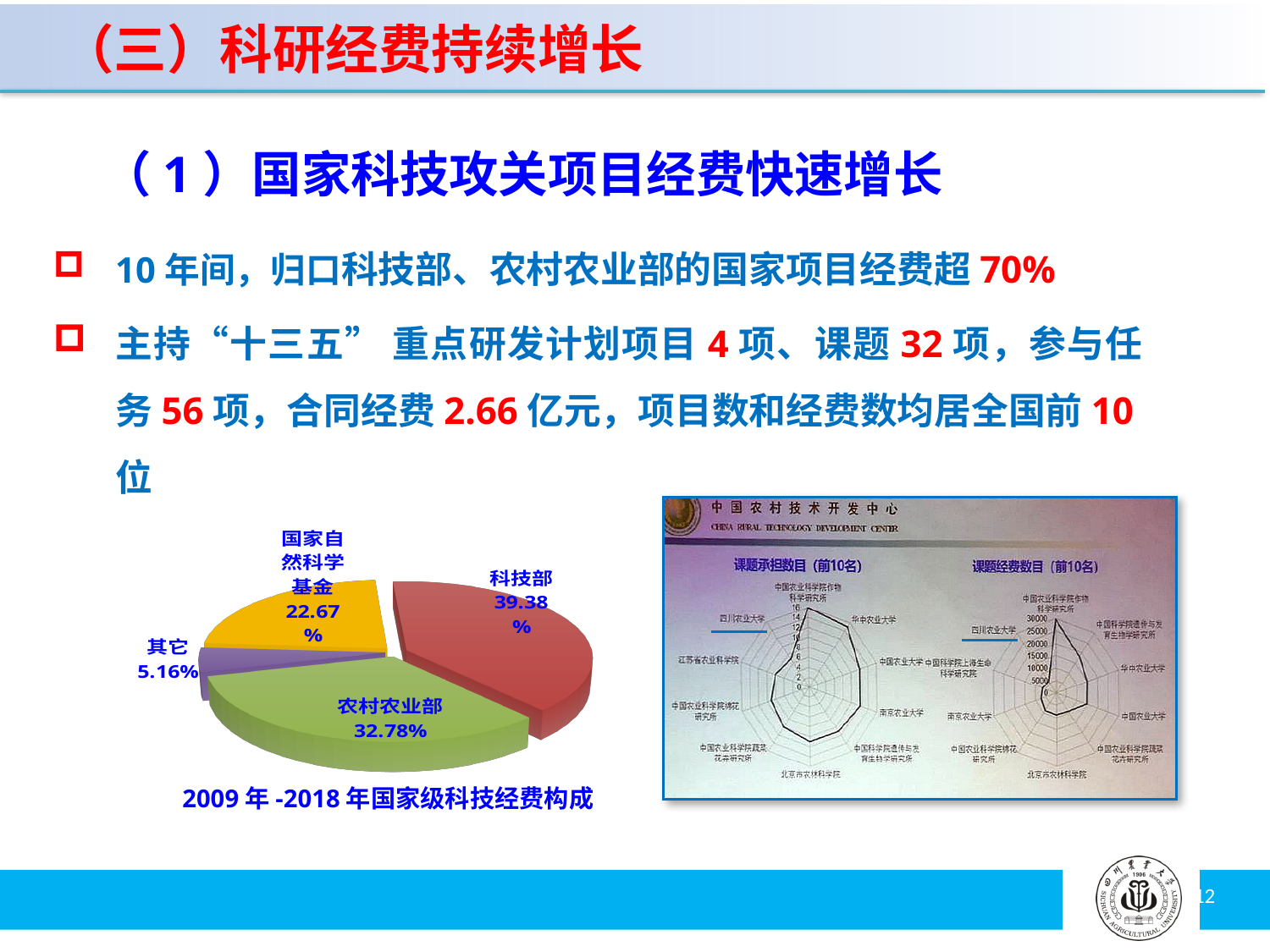
In the pie chart titled 2009年-2018年国家级科技经费构成, how many slices are there? 4 In the pie chart titled 2009年-2018年国家级科技经费构成, what share does 农村农业部 account for? 32.78% In the pie chart titled 2009年-2018年国家级科技经费构成, what share does 国家自然科学基金 account for? 22.67% In the pie chart titled 2009年-2018年国家级科技经费构成, what is the combined share of 科技部 and 农村农业部? 72.16% In the pie chart titled 2009年-2018年国家级科技经费构成, which category has the smallest share? 其它 In the pie chart titled 2009年-2018年国家级科技经费构成, what share does 科技部 account for? 39.38% In the pie chart titled 2009年-2018年国家级科技经费构成, what colour is the 科技部 slice? red In the pie chart titled 2009年-2018年国家级科技经费构成, what share does 其它 account for? 5.16% In the pie chart titled 2009年-2018年国家级科技经费构成, which is larger, the share of 国家自然科学基金 or the share of 其它? 国家自然科学基金 What kind of chart is the one titled 2009年-2018年国家级科技经费构成? pie chart In the pie chart titled 2009年-2018年国家级科技经费构成, which category has the largest share? 科技部 In the pie chart titled 2009年-2018年国家级科技经费构成, what is the difference in percentage points between 科技部 and 农村农业部? 6.60